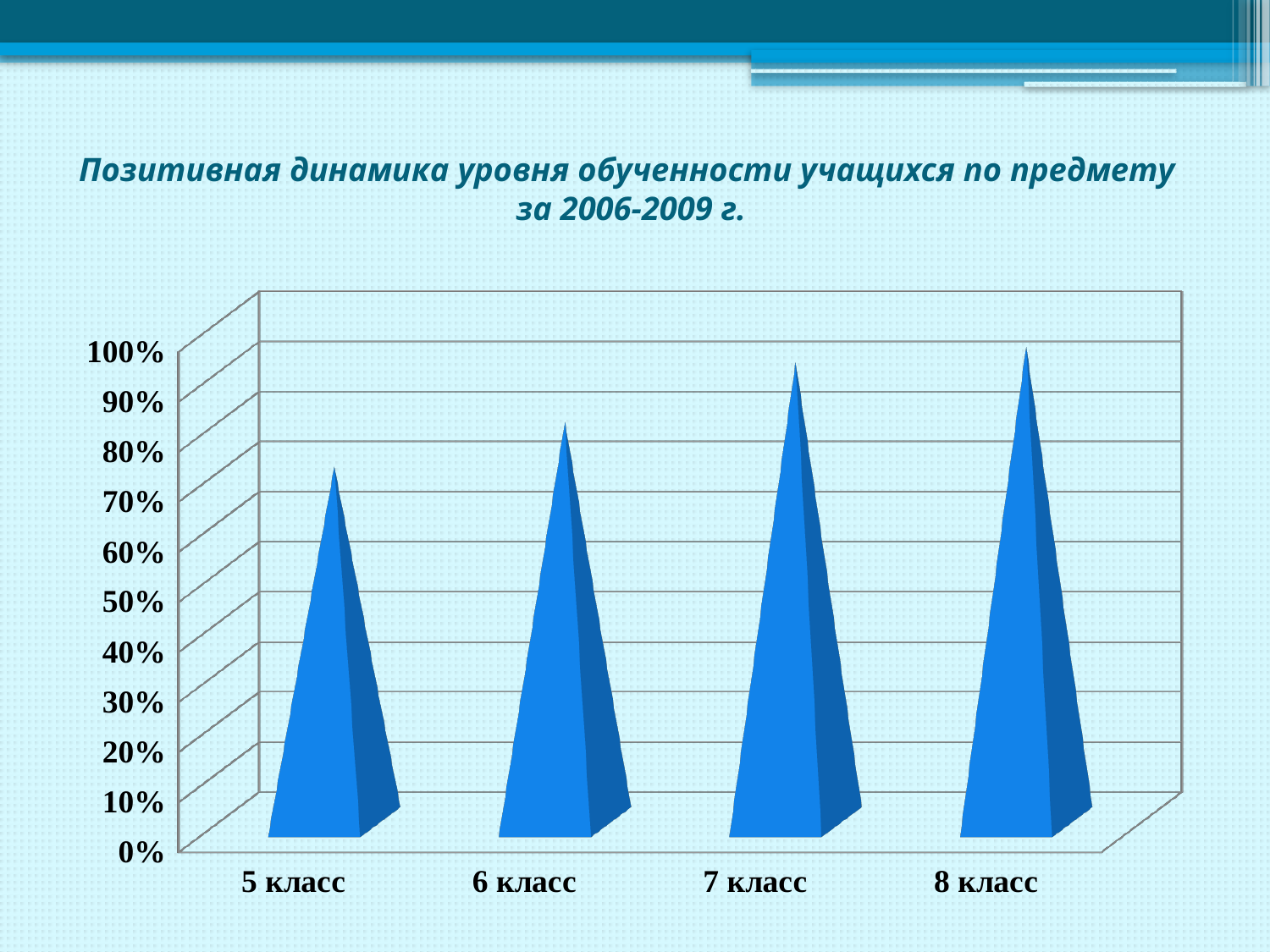
Which is larger, the value for 6 класс or the value for 8 класс? 8 класс Which is larger, the value for 7 класс or the value for 5 класс? 7 класс Is the value for 5 класс greater or less than 60%? greater Which class has the highest value in the chart? 8 класс Is the value for 5 класс greater or less than 90%? less Which class has the lowest value in the chart? 5 класс Is the value for 7 класс greater or less than 80%? greater What is the title of the chart on the slide? Позитивная динамика уровня обученности учащихся по предмету за 2006-2009 г. Do the values rise or fall from 5 класс to 8 класс along the x axis? rise How many categories (classes) are shown on the x axis of the chart? 4 What kind of chart is shown on the slide? bar chart